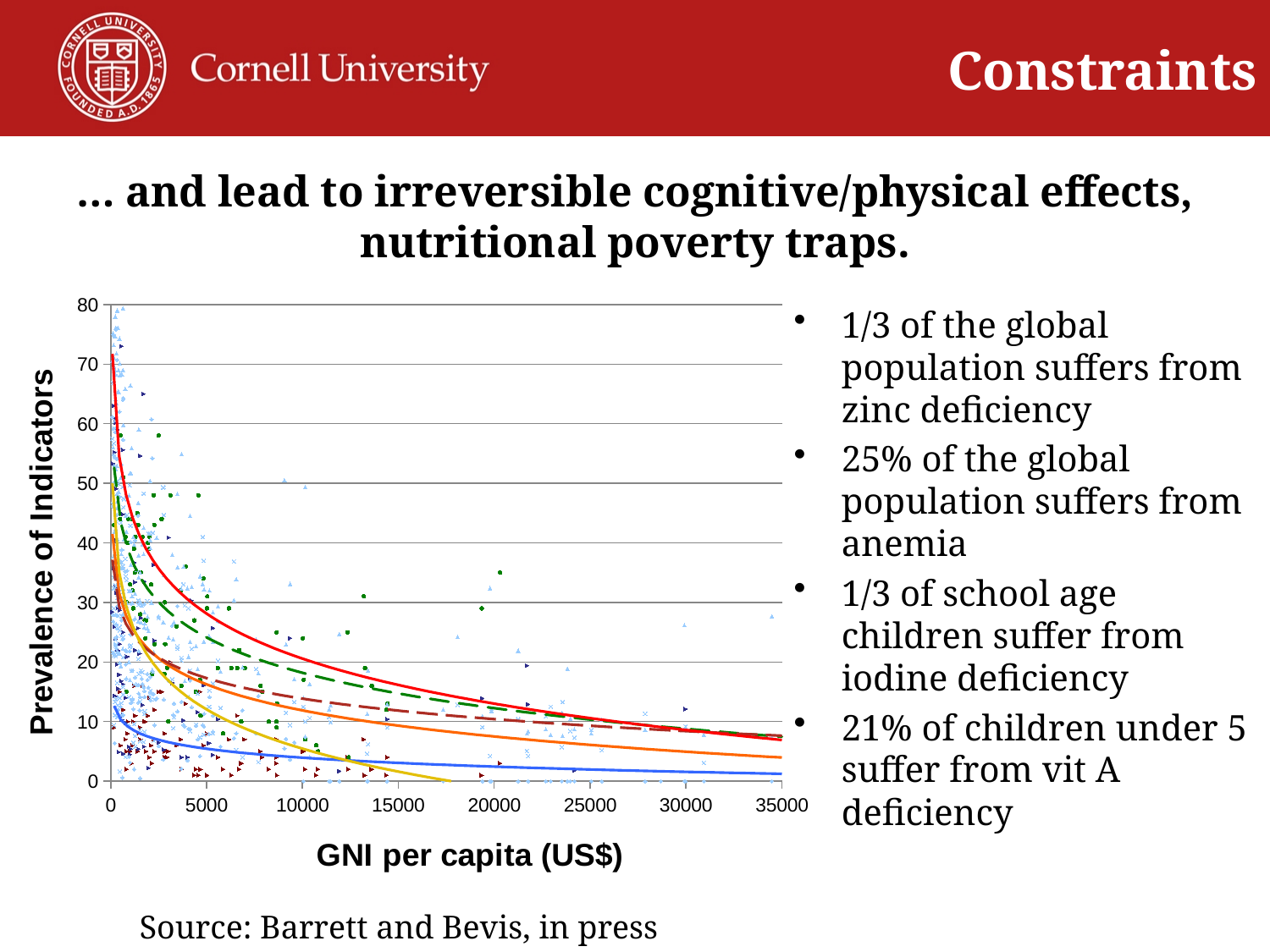
What is the title of the horizontal axis of the chart? GNI per capita (US$) Is the blue curve's value at a GNI per capita of 35000 greater or less than 10? less What is the title of the vertical axis of the chart? Prevalence of Indicators What is the interval between consecutive tick marks on the horizontal axis of the chart? 5000 At a GNI per capita of 5000, which curve is higher, the red curve or the blue curve? The red curve What kind of chart is shown on the slide? Scatter chart What is the highest value shown on the horizontal axis of the chart? 35000 What is the highest value shown on the vertical axis of the chart? 80 Do the fitted curves in the chart rise or fall as GNI per capita increases? Fall Is the red curve's value at a GNI per capita of 35000 greater or less than 20? less Is the red curve's value near a GNI per capita of 0 greater or less than 60? greater Which fitted curve reaches the horizontal axis (a value of 0) before a GNI per capita of 20000? The yellow curve